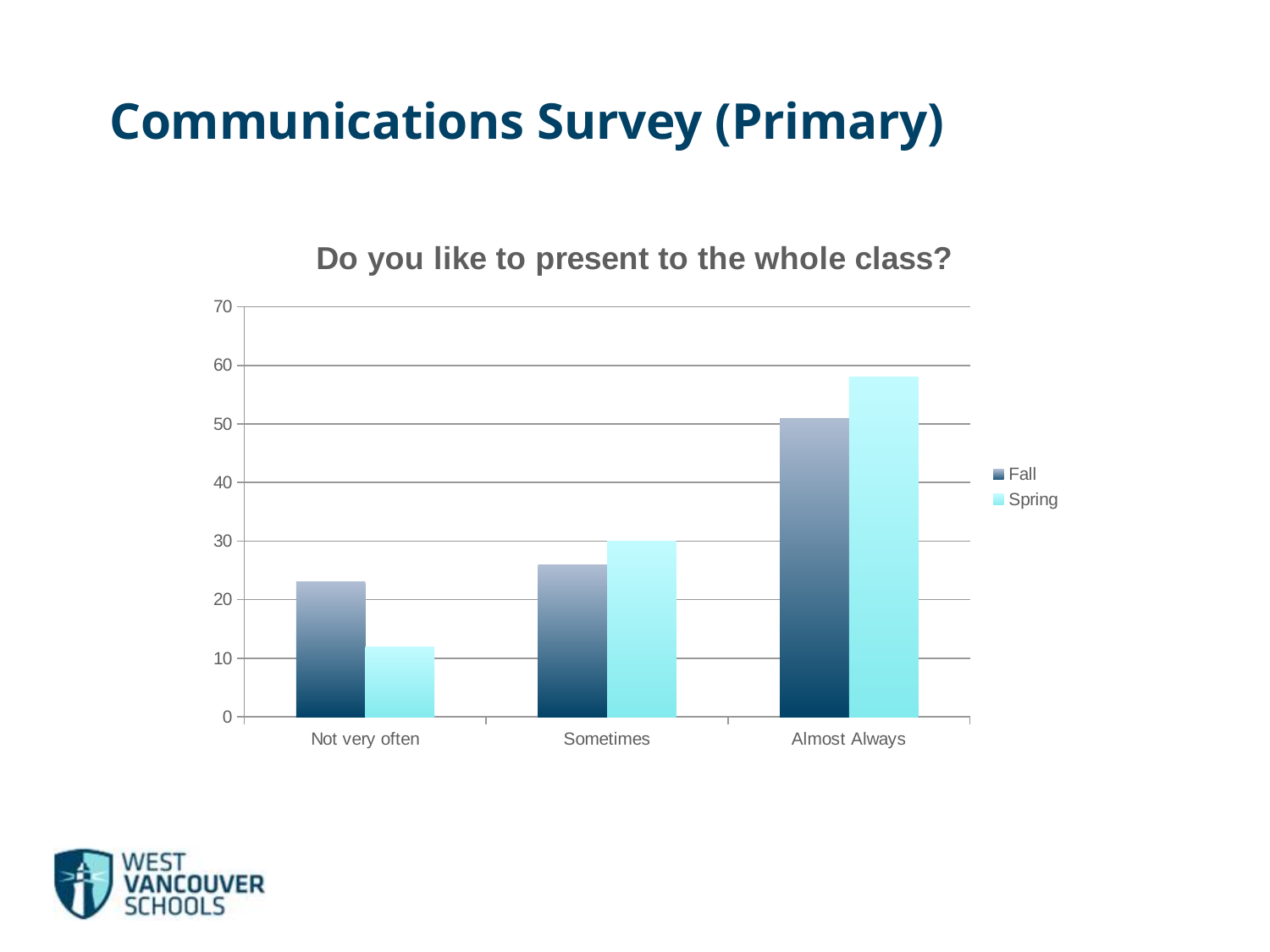
How many series does the chart's legend list? 2 Is the Fall value for 'Almost Always' greater or less than 40? greater For the 'Not very often' category, which series has the larger value, Fall or Spring? Fall Which category has the lowest Spring value? Not very often Which two series are listed in the chart's legend? Fall and Spring Which category has the highest Fall value? Almost Always How many categories are shown on the x axis of the chart? 3 Which category has the highest Spring value? Almost Always What is the title of the chart? Do you like to present to the whole class? Is the Spring value for 'Not very often' greater or less than 20? less What kind of chart is shown on the slide? bar chart For the 'Almost Always' category, which series has the larger value, Fall or Spring? Spring